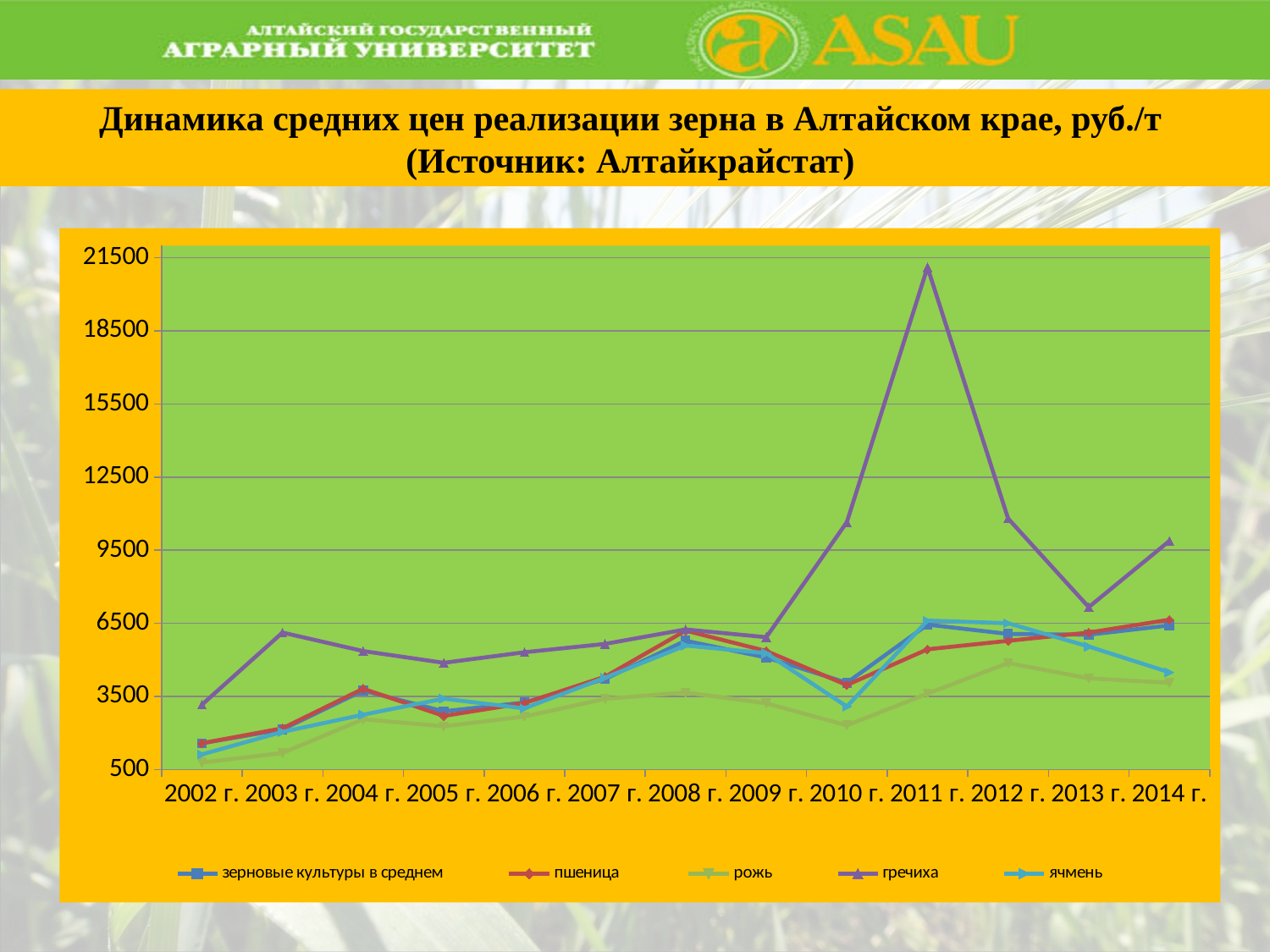
Is the value for рожь in 2010 г. greater or less than 3500? less Is the value for пшеница in 2002 г. greater or less than 3500? less Is the value for гречиха in 2011 г. greater or less than 18500? greater How many years are plotted along the x axis? 13 In which year is the гречиха series at its lowest value? 2002 г. Does the гречиха series rise or fall from 2011 г. to 2013 г.? fall How many series does the legend list? 5 What kind of chart is shown on the slide? line chart In which year does the гречиха series reach its highest value? 2011 г. Which is larger in 2011 г., the value for гречиха or the value for рожь? гречиха What is the source of the data named in the chart title? Алтайкрайстат